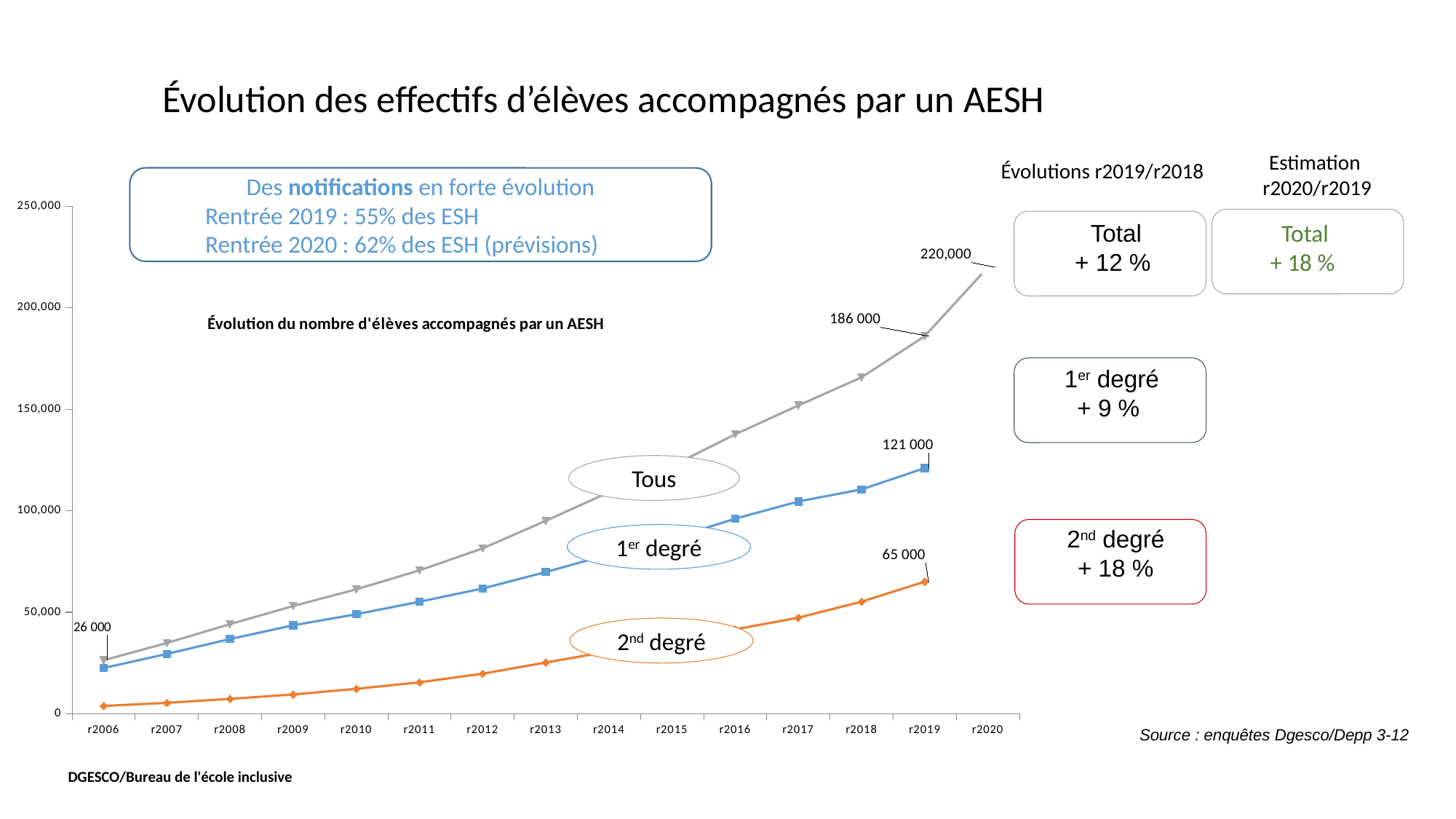
What kind of chart is shown on the slide? line chart At r2019, what is the difference between the '1er degré' value and the '2nd degré' value? 56 000 How many points (years) are shown along the x axis of the chart? 15 What is the value of the 'Tous' series at r2020? 220,000 What is the value of the '1er degré' series at r2019? 121 000 Is the value of the 'Tous' series at r2016 greater or less than 100,000? greater What is the title printed above the chart's plot area? Évolution du nombre d'élèves accompagnés par un AESH What is the value of the 'Tous' series at r2006? 26 000 How many series are plotted on the chart? 3 What is the value of the '2nd degré' series at r2019? 65 000 Does the 'Tous' series rise or fall from r2006 to r2020? rise What is the value of the 'Tous' series at r2019? 186 000